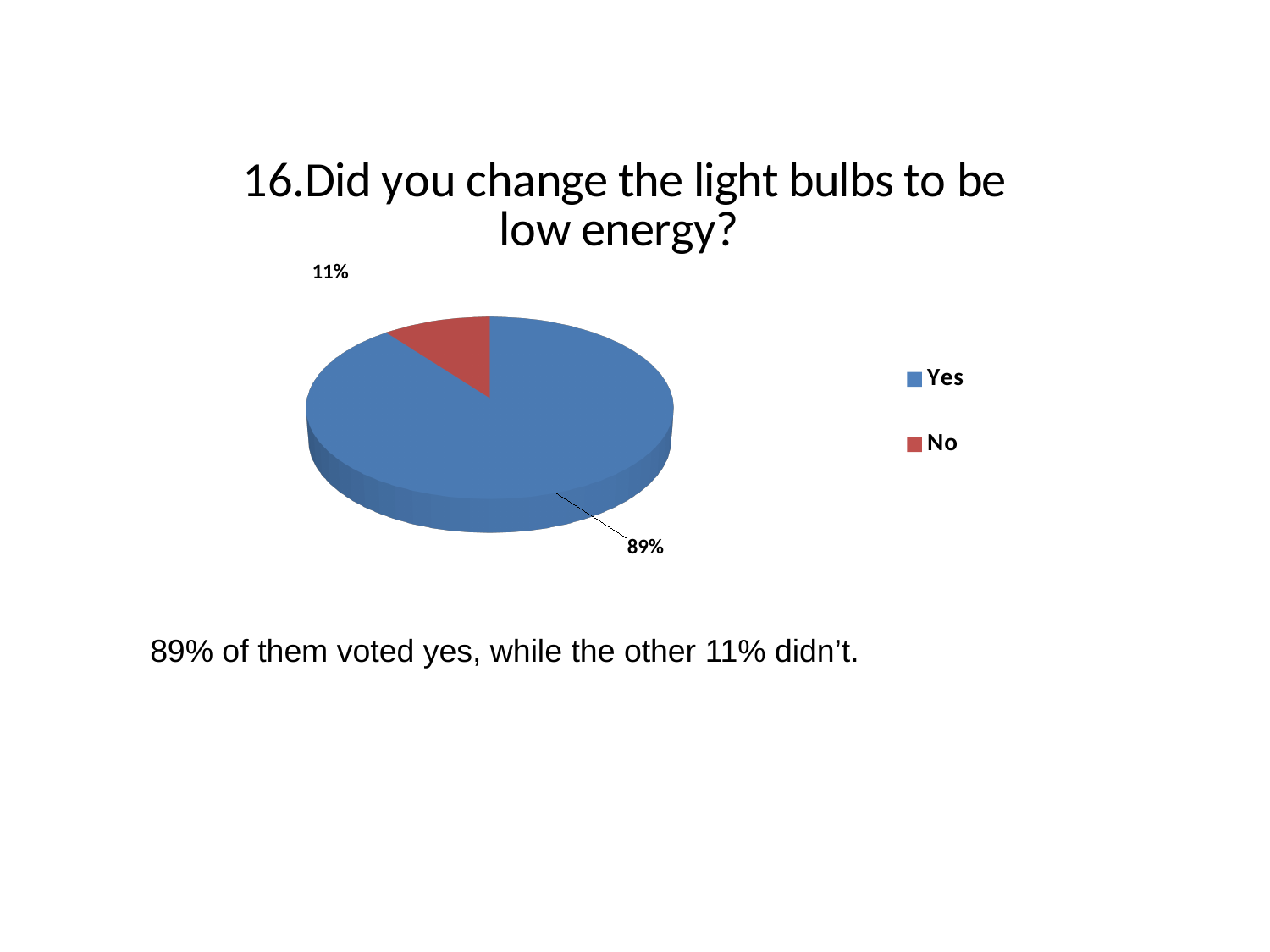
How many slices does the pie chart have? 2 What kind of chart is shown on the slide? Pie chart What percentage of respondents answered Yes? 89% What colour is the Yes slice? Blue Which response has the largest share of the pie? Yes What is the difference in percentage points between the Yes and No shares? 78 What percentage of respondents answered No? 11% Which is larger, the share for Yes or the share for No? Yes Which response has the smallest share of the pie? No What share of the pie does the No slice represent? 11% How many entries does the legend list? 2 What is the title of the chart? 16.Did you change the light bulbs to be low energy?